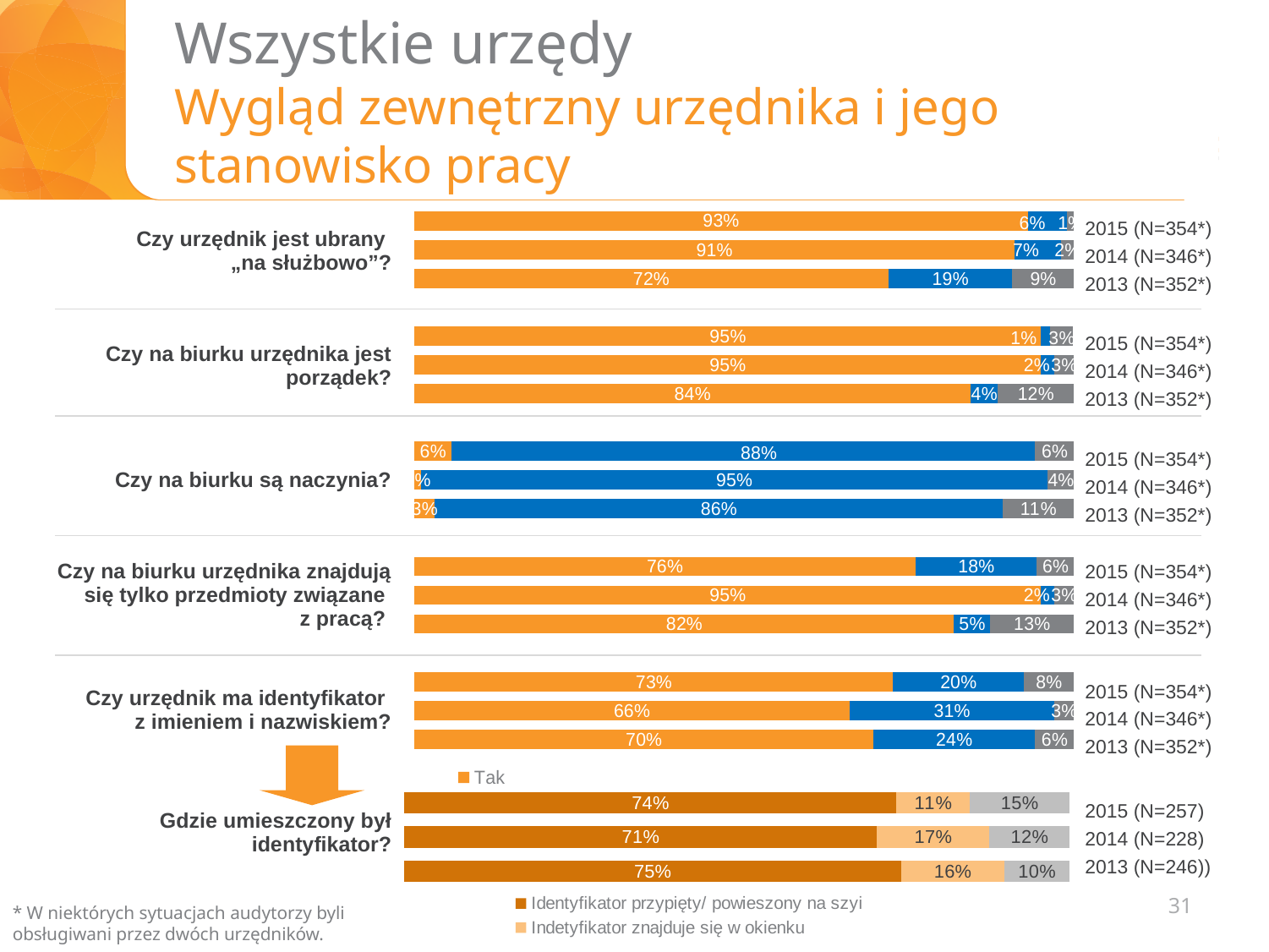
In the chart "Czy urzędnik jest ubrany „na służbowo”?", what is the value of the orange (Tak) segment for 2015 (N=354*)? 93% In the chart "Czy urzędnik jest ubrany „na służbowo”?", which year has the lowest orange (Tak) value? 2013 (N=352*) In the chart "Czy na biurku są naczynia?", what is the value of the blue segment for 2014 (N=346*)? 95% In the chart "Czy na biurku urzędnika znajdują się tylko przedmioty związane z pracą?", what is the difference between the orange (Tak) values for 2014 (N=346*) and 2015 (N=354*)? 19% What type of chart is used on this slide? Stacked bar chart How many year bars are shown in the chart "Gdzie umieszczony był identyfikator?"? 3 In the chart "Czy urzędnik jest ubrany „na służbowo”?", what is the value of the blue segment for 2013 (N=352*)? 19% In the chart "Czy urzędnik ma identyfikator z imieniem i nazwiskiem?", is the orange (Tak) value larger for 2015 (N=354*) or 2013 (N=352*)? 2015 (N=354*) In the chart "Czy na biurku urzędnika jest porządek?", what is the value of the grey segment for 2013 (N=352*)? 12% In the chart "Czy urzędnik ma identyfikator z imieniem i nazwiskiem?", which year has the highest blue segment value? 2014 (N=346*) In the chart "Gdzie umieszczony był identyfikator?", what is the value for "Indetyfikator znajduje się w okienku" in 2013 (N=246)? 16% In the chart "Gdzie umieszczony był identyfikator?", what is the value for "Identyfikator przypięty/ powieszony na szyi" in 2014 (N=228)? 71%